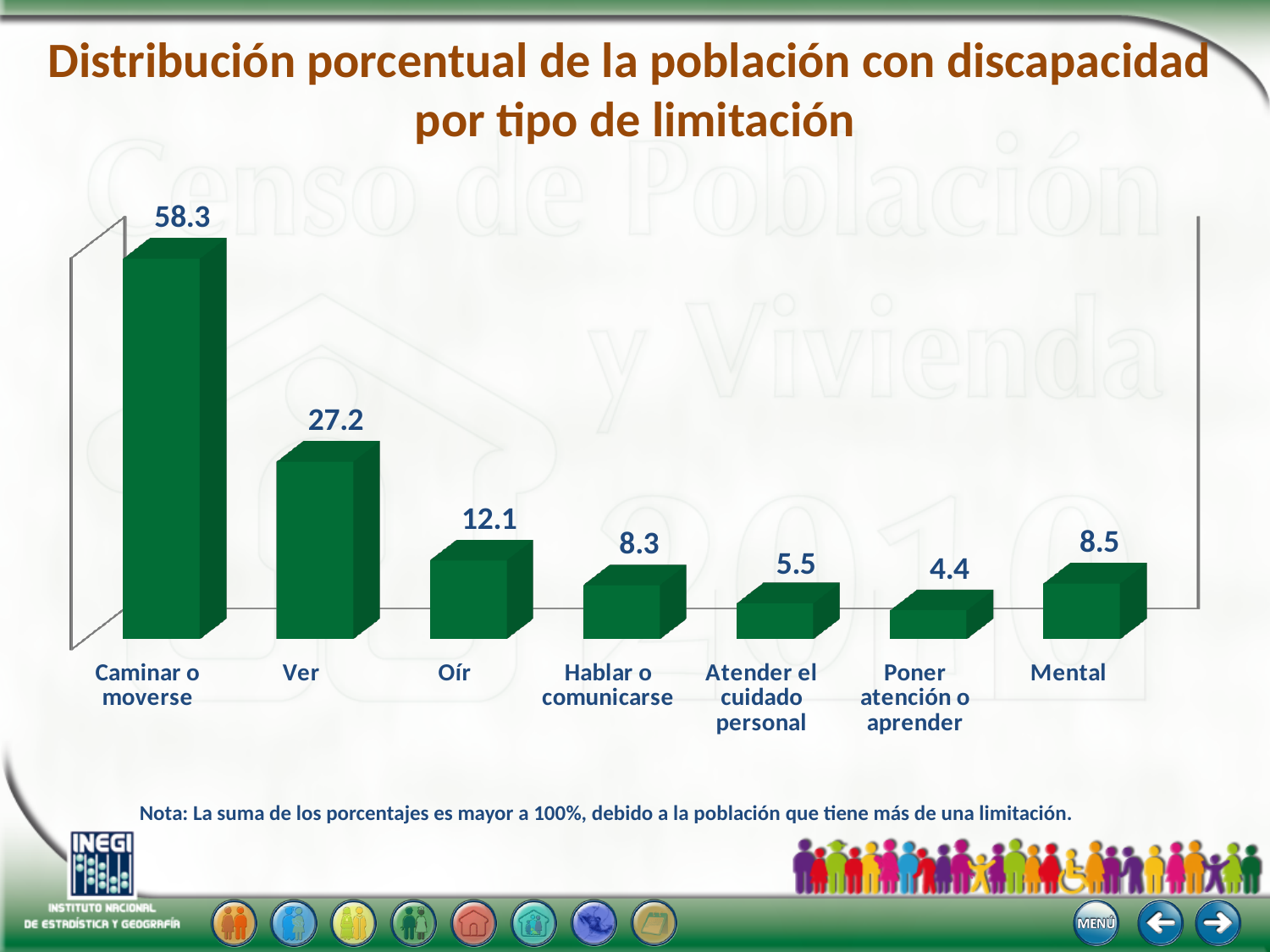
How many categories are shown in the chart? 7 Which is larger, the value for "Mental" or the value for "Hablar o comunicarse"? Mental What is the value for "Caminar o moverse"? 58.3 What is the value for "Mental"? 8.5 Which category has the lowest value? Poner atención o aprender What kind of chart is shown on the slide? Bar chart What is the difference between the values for "Caminar o moverse" and "Ver"? 31.1 What is the title of the chart? Distribución porcentual de la población con discapacidad por tipo de limitación Which category has the highest value? Caminar o moverse What is the difference between the values for "Oír" and "Hablar o comunicarse"? 3.8 What is the value for "Atender el cuidado personal"? 5.5 What is the value for "Ver"? 27.2